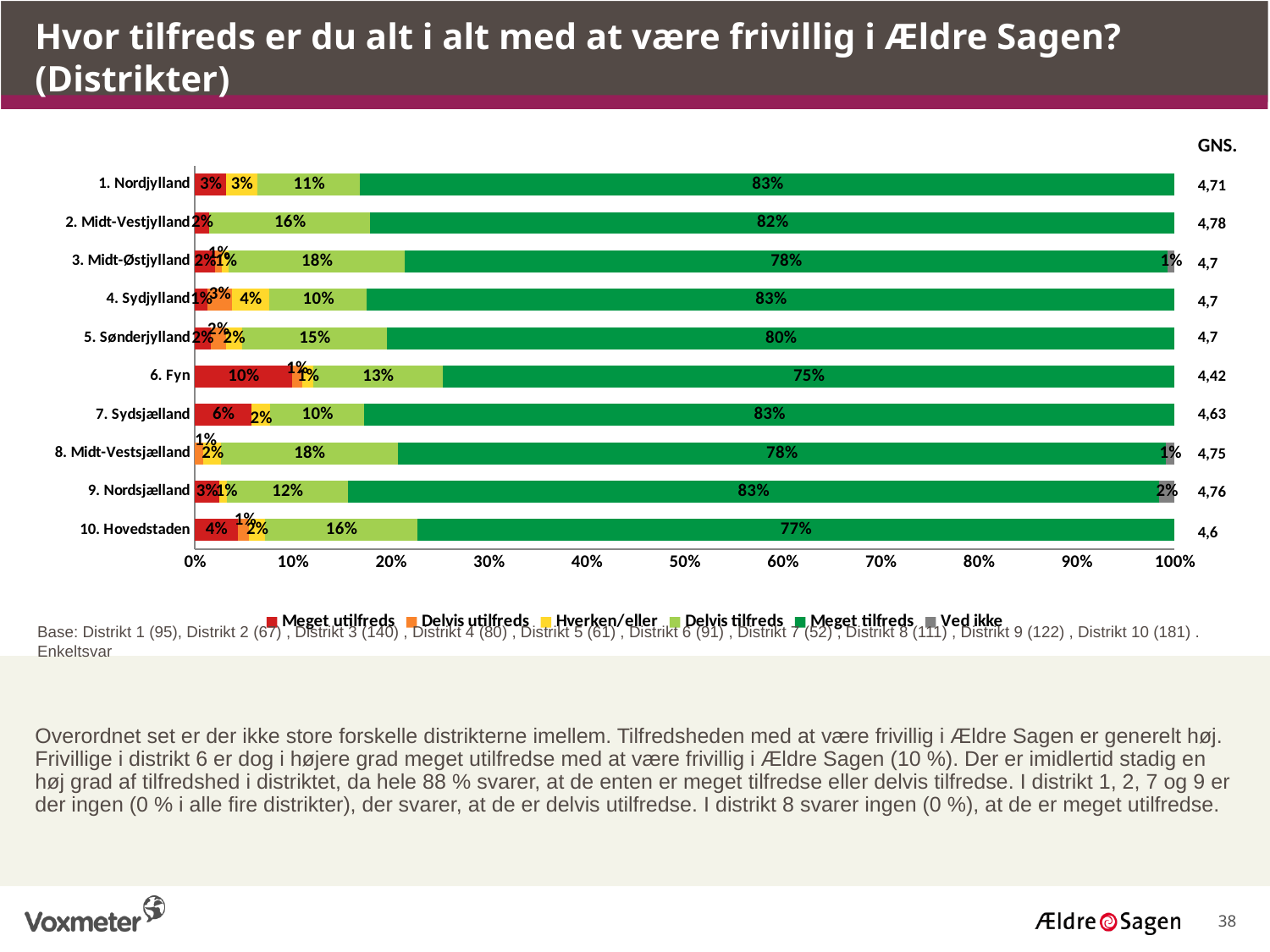
Which district has the highest "Meget utilfreds" share? 6. Fyn Which district has the lowest "Meget tilfreds" share? 6. Fyn What is the GNS. value shown for 6. Fyn? 4,42 What percentage of volunteers in 6. Fyn answered "Meget tilfreds"? 75% How many districts are shown in the chart? 10 Which district has the highest GNS. value? 2. Midt-Vestjylland What is the difference in percentage points between the "Meget tilfreds" share for 1. Nordjylland and for 6. Fyn? 8 percentage points What kind of chart is shown on the slide? Stacked bar chart What percentage of volunteers in 3. Midt-Østjylland answered "Delvis tilfreds"? 18% How many series does the legend list? 6 Which has a larger "Delvis tilfreds" share, 2. Midt-Vestjylland or 4. Sydjylland? 2. Midt-Vestjylland What is the "Meget utilfreds" share for 7. Sydsjælland? 6%